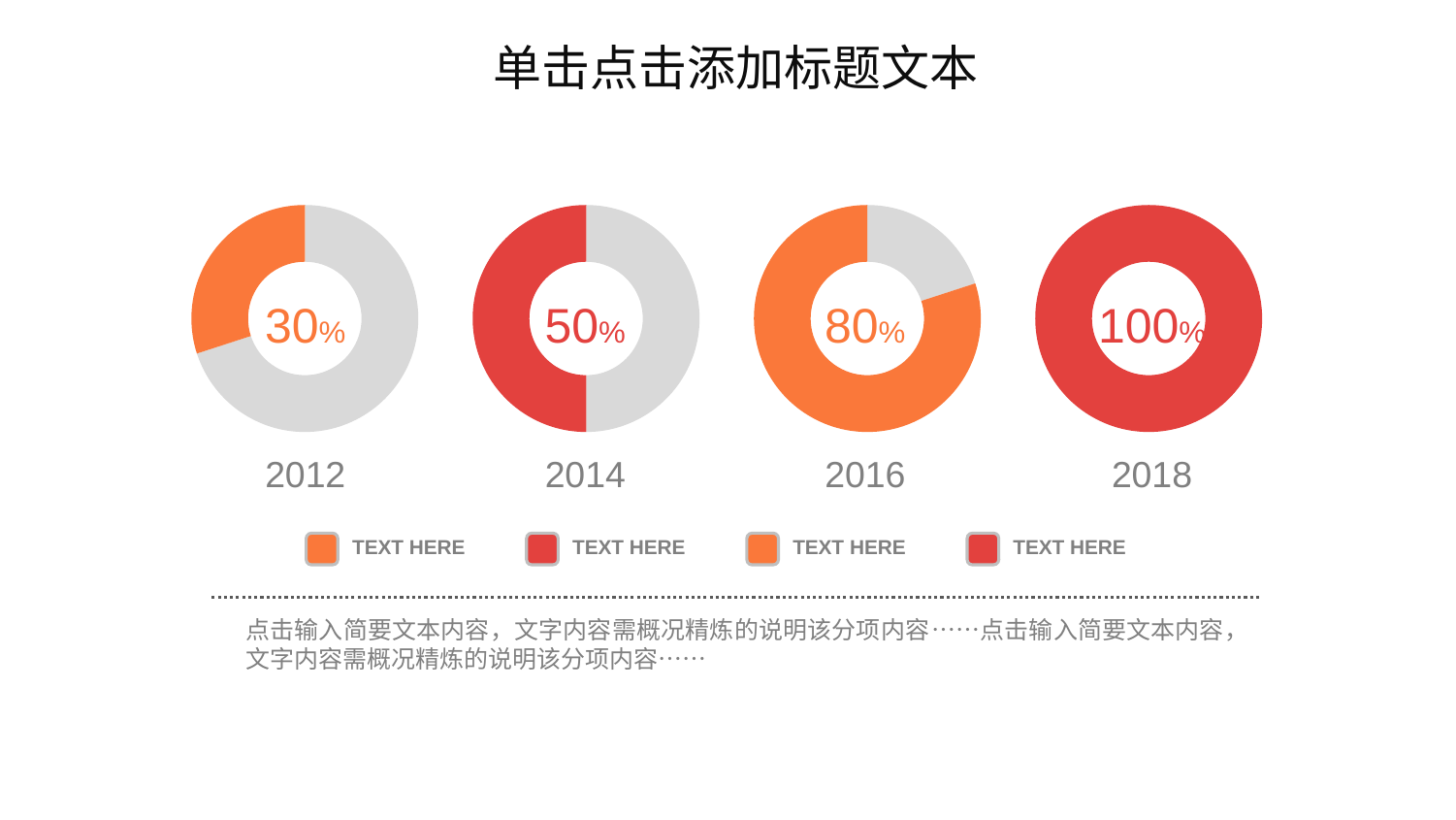
Which year's donut chart shows the highest value? 2018 Do the values in the donut charts rise or fall from 2012 to 2018? Rise How many donut charts are shown on the slide? 4 What value is shown in the donut chart labelled 2014? 50% What value is shown in the donut chart labelled 2018? 100% Which year's donut chart shows the lowest value? 2012 Which is larger, the value in the 2014 donut chart or the value in the 2016 donut chart? 2016 What colour is the filled portion of the donut chart labelled 2014? Red What kind of chart is used for each of the four years on the slide? Donut chart What value is shown in the donut chart labelled 2012? 30% What is the difference between the value in the 2016 donut chart and the value in the 2012 donut chart? 50% What value is shown in the donut chart labelled 2016? 80%